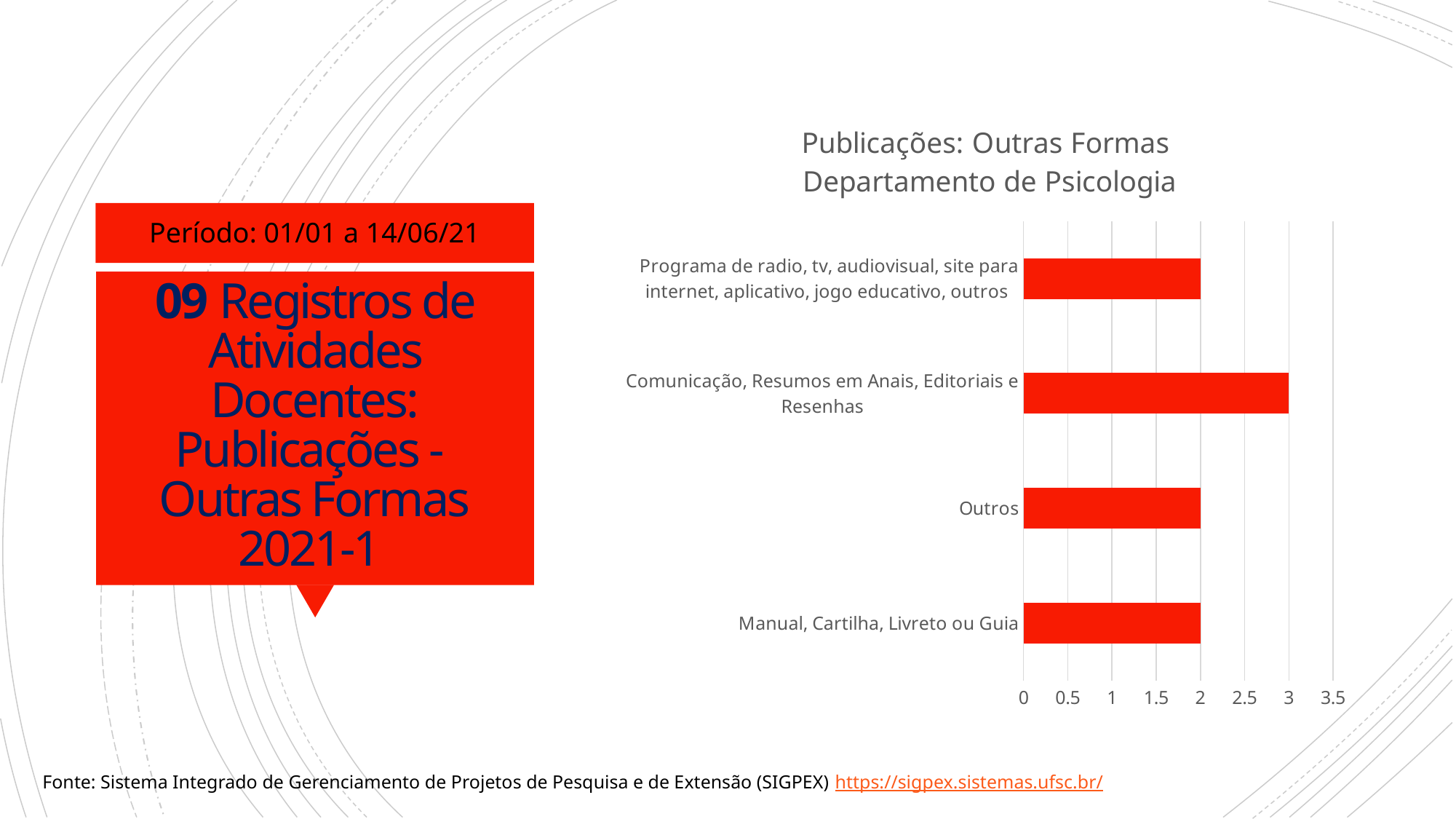
Which is larger: the value for "Comunicação, Resumos em Anais, Editoriais e Resenhas" or the value for "Manual, Cartilha, Livreto ou Guia"? Comunicação, Resumos em Anais, Editoriais e Resenhas Which category has the highest value? Comunicação, Resumos em Anais, Editoriais e Resenhas What is the highest value shown on the horizontal axis of the chart? 3.5 What is the value for "Outros"? 2 How many categories does the chart show? 4 Is the value for "Comunicação, Resumos em Anais, Editoriais e Resenhas" greater or less than 2.5? greater What is the value for "Manual, Cartilha, Livreto ou Guia"? 2 What kind of chart is shown on the slide? bar chart What is the difference between the value for "Comunicação, Resumos em Anais, Editoriais e Resenhas" and the value for "Outros"? 1 What is the title of the chart? Publicações: Outras Formas Departamento de Psicologia What is the value for "Programa de radio, tv, audiovisual, site para internet, aplicativo, jogo educativo, outros"? 2 What is the value for "Comunicação, Resumos em Anais, Editoriais e Resenhas"? 3